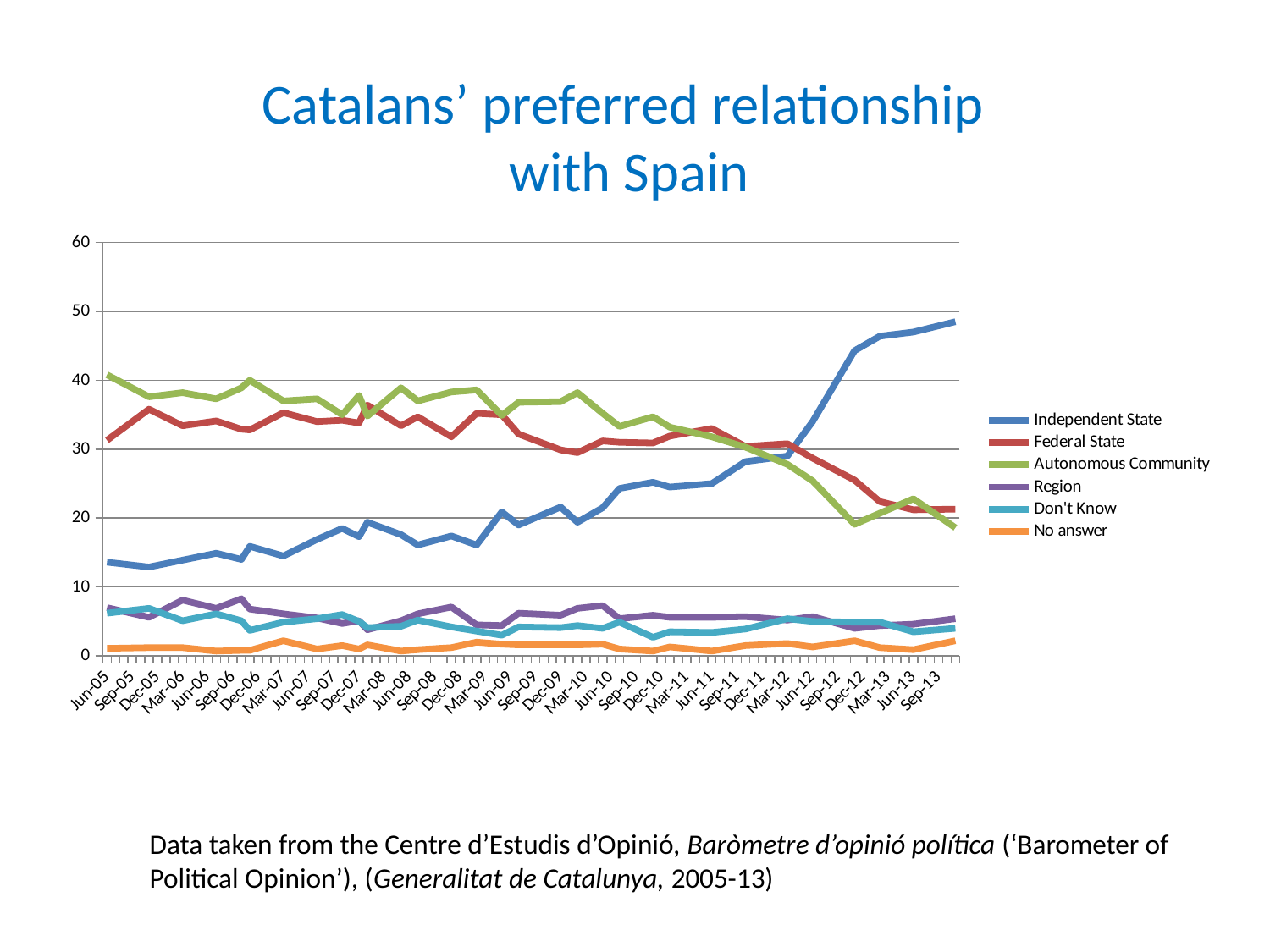
Is the value for Federal State at Sep-13 greater or less than 30? less Which series has the highest value at Jun-05? Autonomous Community Is the value for Independent State at Jun-05 greater or less than 20? less What is the title of the chart? Catalans' preferred relationship with Spain Does the Independent State line rise or fall overall from Jun-05 to Sep-13? Rises What kind of chart is shown on the slide? Line chart Which series is drawn in blue? Independent State Which series has the highest value at Sep-13? Independent State How many series does the legend list? 6 Is the value for Independent State at Sep-13 greater or less than 40? greater Does the Autonomous Community line rise or fall overall from Jun-05 to Sep-13? Falls At Sep-13, which is larger: Independent State or Federal State? Independent State